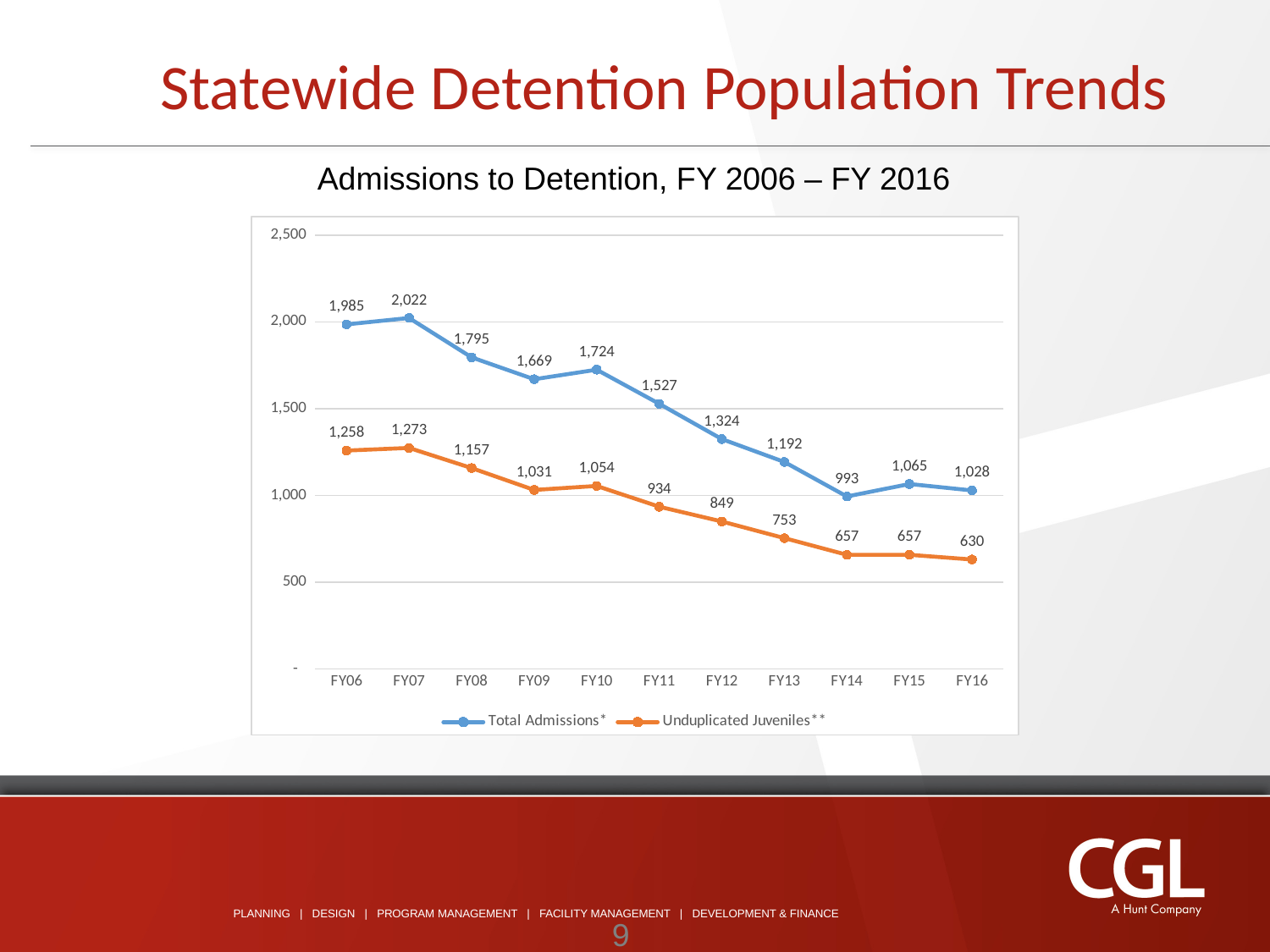
What is the value of Unduplicated Juveniles in FY12? 849 Is the value for Unduplicated Juveniles in FY13 greater or less than 1,000? less What is the value of Total Admissions in FY07? 2,022 In which fiscal year is Unduplicated Juveniles lowest? FY16 What kind of chart is shown on the slide? line chart In which fiscal year is Total Admissions highest? FY07 How many fiscal years are shown on the x axis? 11 What is the difference between Total Admissions and Unduplicated Juveniles in FY06? 727 What is the value of Total Admissions in FY14? 993 How many series does the legend list? 2 Which is larger: Total Admissions in FY15 or Total Admissions in FY16? FY15 Do Total Admissions generally rise or fall from FY06 to FY16? fall